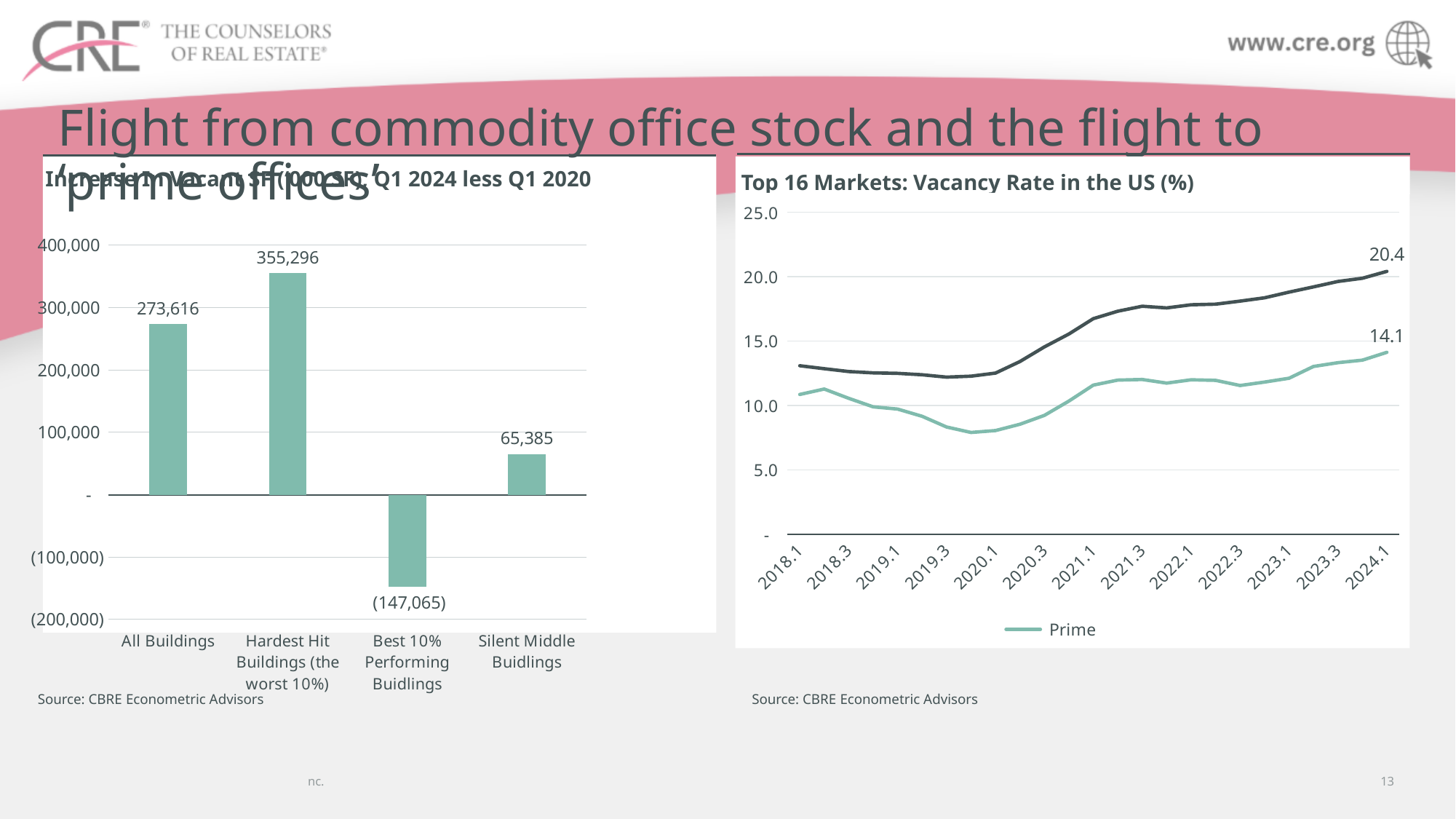
In the bar chart on the left, what is the difference between the values for Hardest Hit Buildings (the worst 10%) and All Buildings? 81,680 In the bar chart on the left, what is the value for Best 10% Performing Buidlings? (147,065) In the chart titled 'Top 16 Markets: Vacancy Rate in the US (%)', does the Prime line rise or fall from 2020.1 to 2024.1? Rise In the chart titled 'Top 16 Markets: Vacancy Rate in the US (%)', what is the difference between the two labelled values at 2024.1, 20.4 and 14.1? 6.3 How many categories are shown in the bar chart on the left? 4 In the chart titled 'Top 16 Markets: Vacancy Rate in the US (%)', is the value of the Prime line at 2020.1 greater or less than 10.0? less What kind of chart is the chart on the left of the slide? Bar chart In the bar chart on the left, which category has the lowest value? Best 10% Performing Buidlings In the bar chart on the left, which is larger: the value for All Buildings or the value for Silent Middle Buidlings? All Buildings In the chart titled 'Top 16 Markets: Vacancy Rate in the US (%)', what is the final labelled value of the Prime line at 2024.1? 14.1 In the bar chart on the left, what is the value for Hardest Hit Buildings (the worst 10%)? 355,296 In the bar chart on the left, which category has the highest value? Hardest Hit Buildings (the worst 10%)